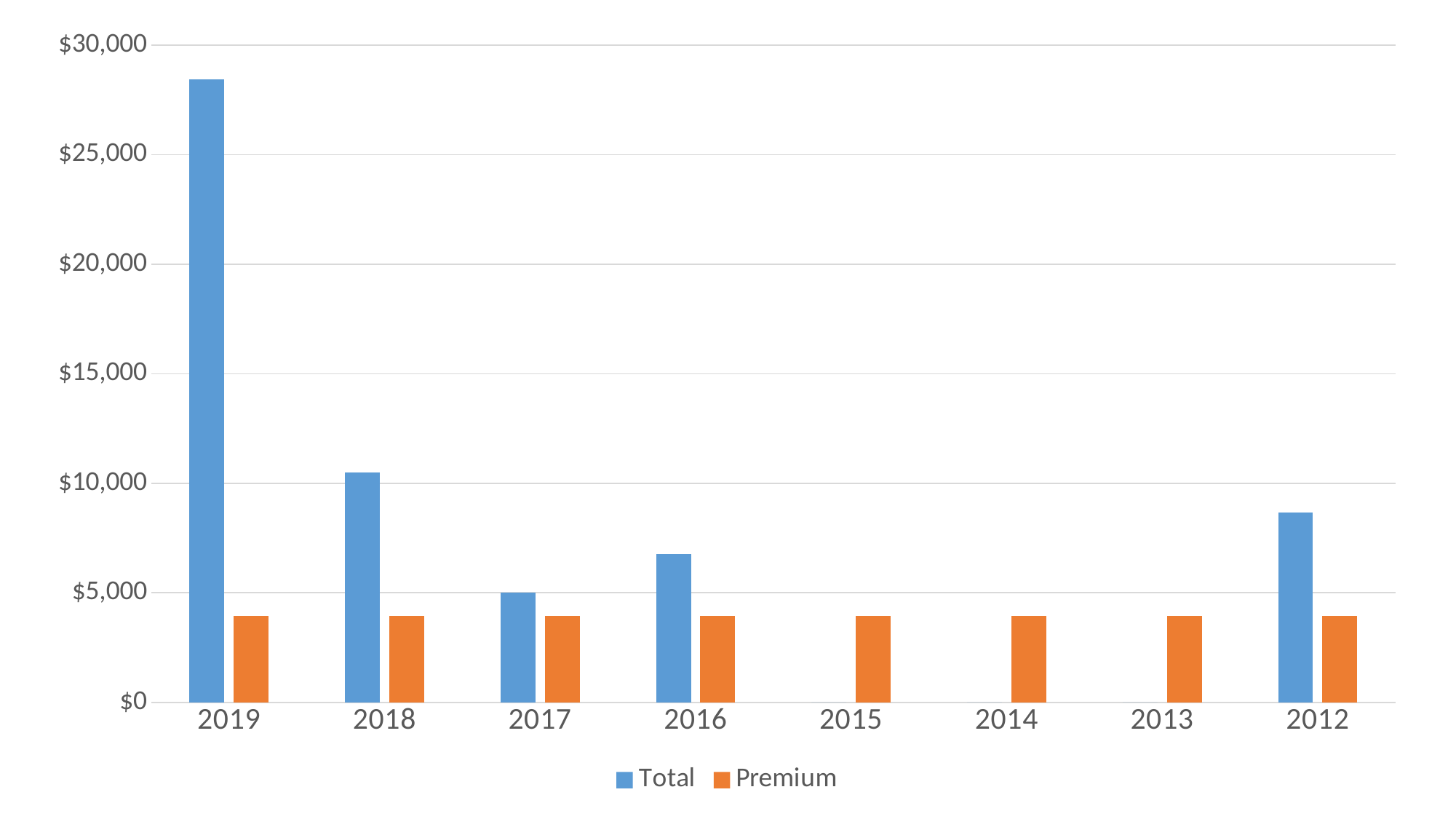
Is the Total value for 2012 greater or less than $10,000? less What are the two series named in the legend? Total and Premium What kind of chart is shown on the slide? bar chart Is the Premium value for 2019 greater or less than $5,000? less Is the Total value for 2019 greater or less than $25,000? greater How many series does the legend list? 2 Which is larger, the Total value for 2016 or the Total value for 2012? 2012 For 2018, which series has the larger value, Total or Premium? Total Which year has the highest Total value? 2019 How many years are shown on the x axis? 8 How many years show a Total bar? 5